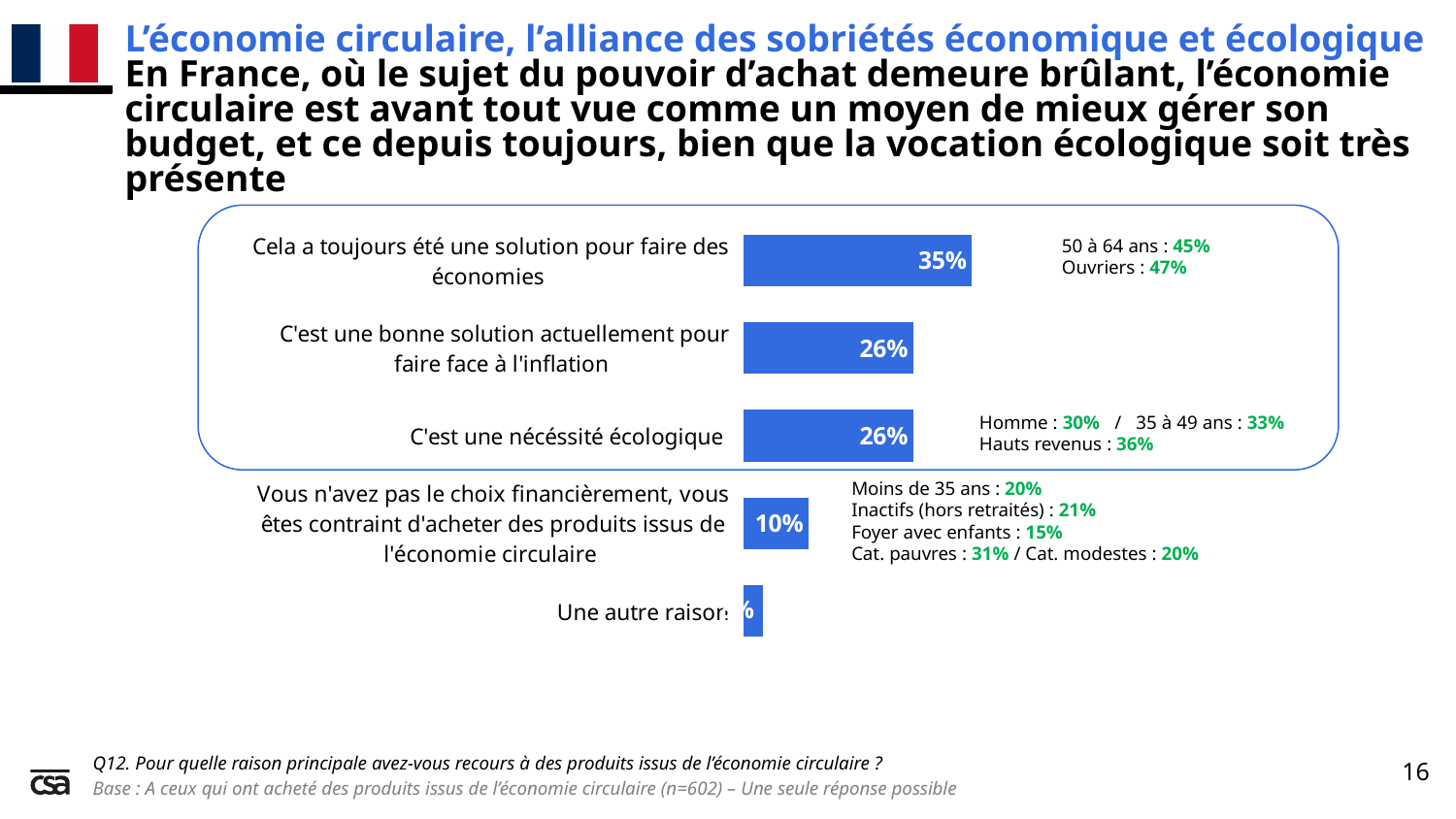
What is the value for "Vous n'avez pas le choix financièrement, vous êtes contraint d'acheter des produits issus de l'économie circulaire"? 10% What is the value for "C'est une nécéssité écologique"? 26% How many categories are plotted in the chart? 5 What is the value for "C'est une bonne solution actuellement pour faire face à l'inflation"? 26% What colour are the bars in the chart? blue What is the difference between the value for "Cela a toujours été une solution pour faire des économies" and the value for "C'est une nécéssité écologique"? 9% What is the difference between the value for "C'est une bonne solution actuellement pour faire face à l'inflation" and the value for "Vous n'avez pas le choix financièrement, vous êtes contraint d'acheter des produits issus de l'économie circulaire"? 16% Which category has the highest value? Cela a toujours été une solution pour faire des économies What kind of chart is shown on the slide? bar chart What is the value for "Cela a toujours été une solution pour faire des économies"? 35% Which is larger: the value for "Cela a toujours été une solution pour faire des économies" or the value for "Vous n'avez pas le choix financièrement, vous êtes contraint d'acheter des produits issus de l'économie circulaire"? Cela a toujours été une solution pour faire des économies Which category has the lowest value? Une autre raison